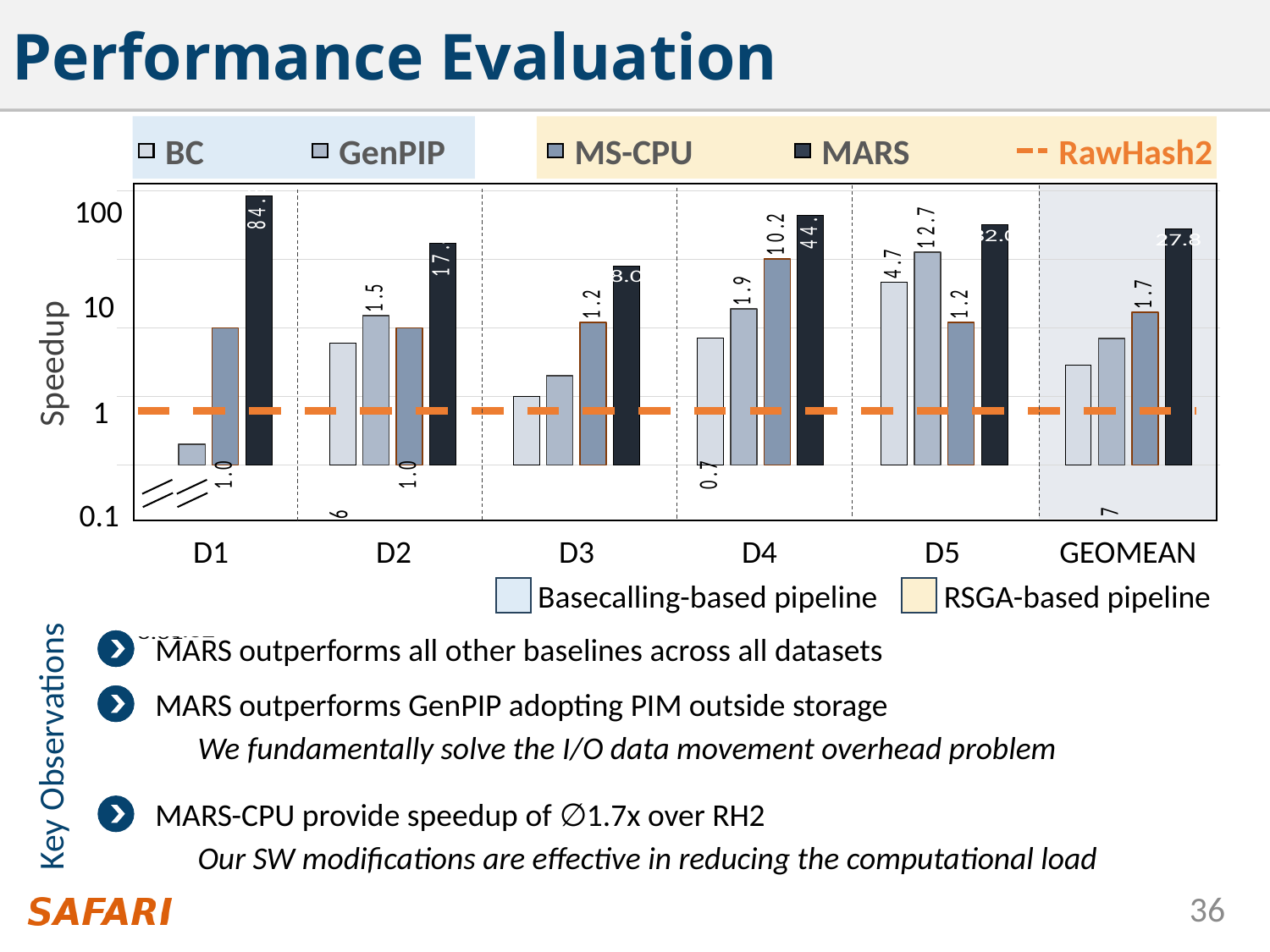
For D5, which is larger: the speedup of BC or of GenPIP? GenPIP Which series has the highest speedup for D5? MARS What is the speedup of MARS for GEOMEAN? 27.8 How many categories are shown along the x axis of the chart? 6 What is the speedup of MS-CPU for GEOMEAN? 1.7 What is the speedup of GenPIP for D5? 12.7 For D5, what is the difference between the GenPIP speedup and the BC speedup? 8.0 How many entries does the chart's legend list? 5 What kind of chart is shown on the slide? bar chart What is the speedup of BC for D4? 0.7 What is the speedup of MS-CPU for D4? 10.2 Is the MARS speedup for D1 greater or less than 10? greater